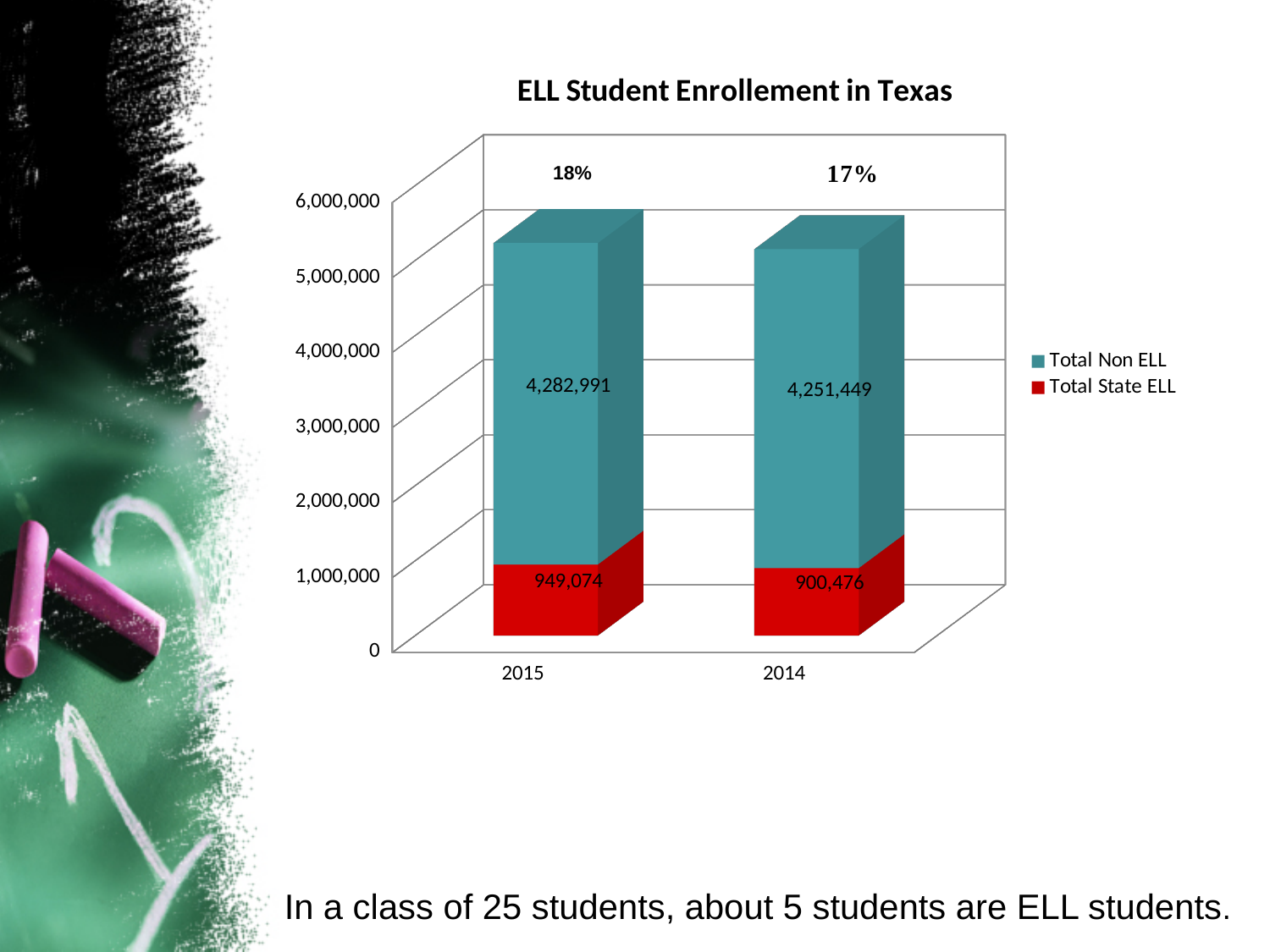
What is the difference between the Total Non ELL values for 2015 and 2014? 31,542 Which year has the higher Total State ELL value? 2015 What is the Total Non ELL value for 2014? 4,251,449 What is the Total Non ELL value for 2015? 4,282,991 What is the Total State ELL value for 2015? 949,074 What is the Total State ELL value for 2014? 900,476 How many series does the legend list? 2 What is the difference between the Total State ELL values for 2015 and 2014? 48,598 What is the total of the stacked bar for 2015? 5,232,065 What kind of chart is shown on the slide? Stacked bar chart Which year has the lower Total Non ELL value? 2014 What is the total of the stacked bar for 2014? 5,151,925